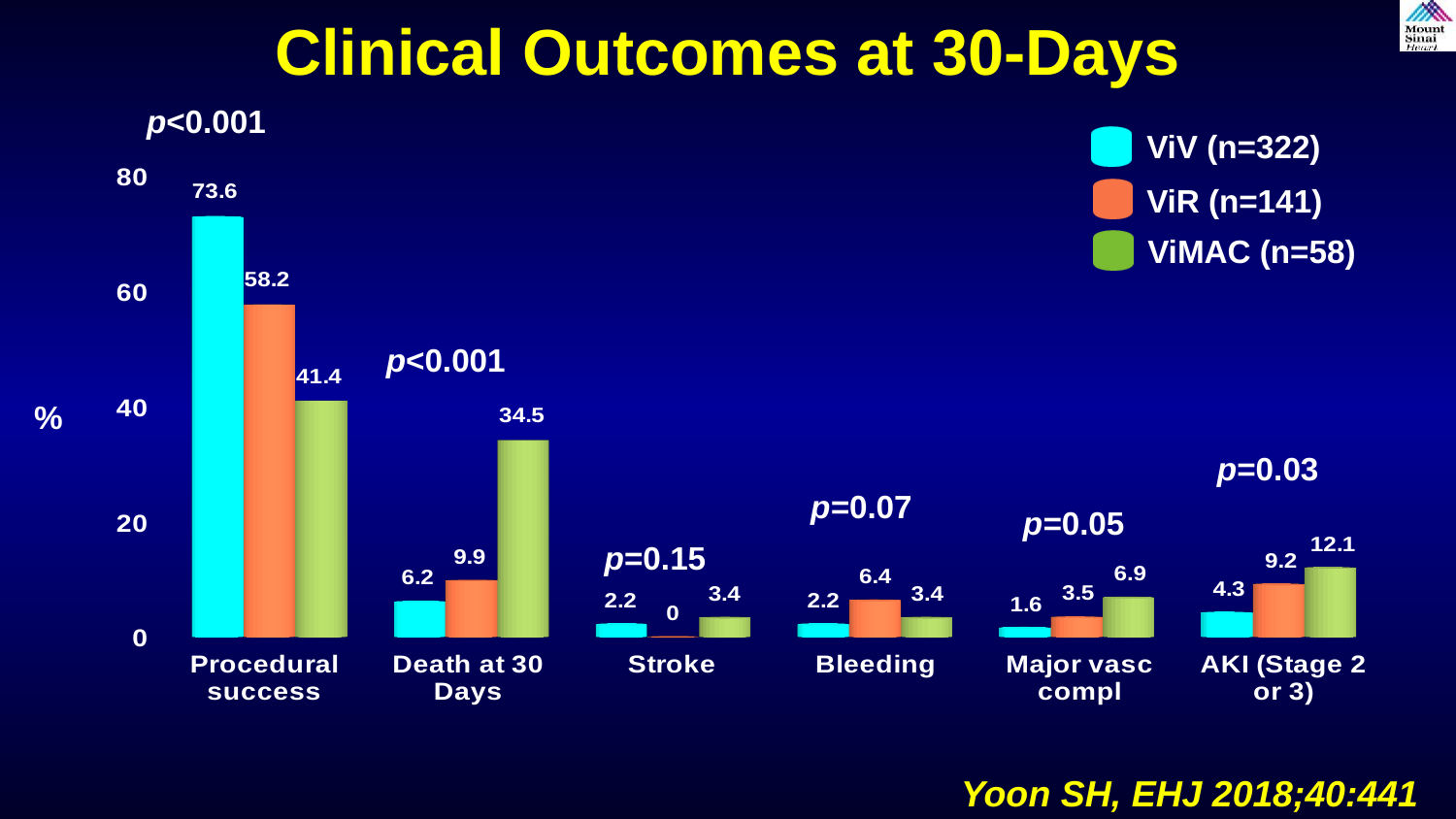
What is the procedural success value for ViV (n=322)? 73.6 What is the value for ViMAC (n=58) for Death at 30 Days? 34.5 What p-value is shown above the Major vasc compl bars? p=0.05 For Bleeding, which is larger: the ViR (n=141) value or the ViMAC (n=58) value? ViR (n=141) Which group has the lowest value for Major vasc compl? ViV (n=322) Which group has the highest value for AKI (Stage 2 or 3)? ViMAC (n=58) Is the ViR (n=141) value for Procedural success greater or less than 60? less How many series does the legend list? 3 How many outcome categories are shown on the x axis? 6 What is the difference between the ViV (n=322) and ViMAC (n=58) values for Procedural success? 32.2 What kind of chart is shown on the slide? Bar chart What is the Stroke value for ViR (n=141)? 0